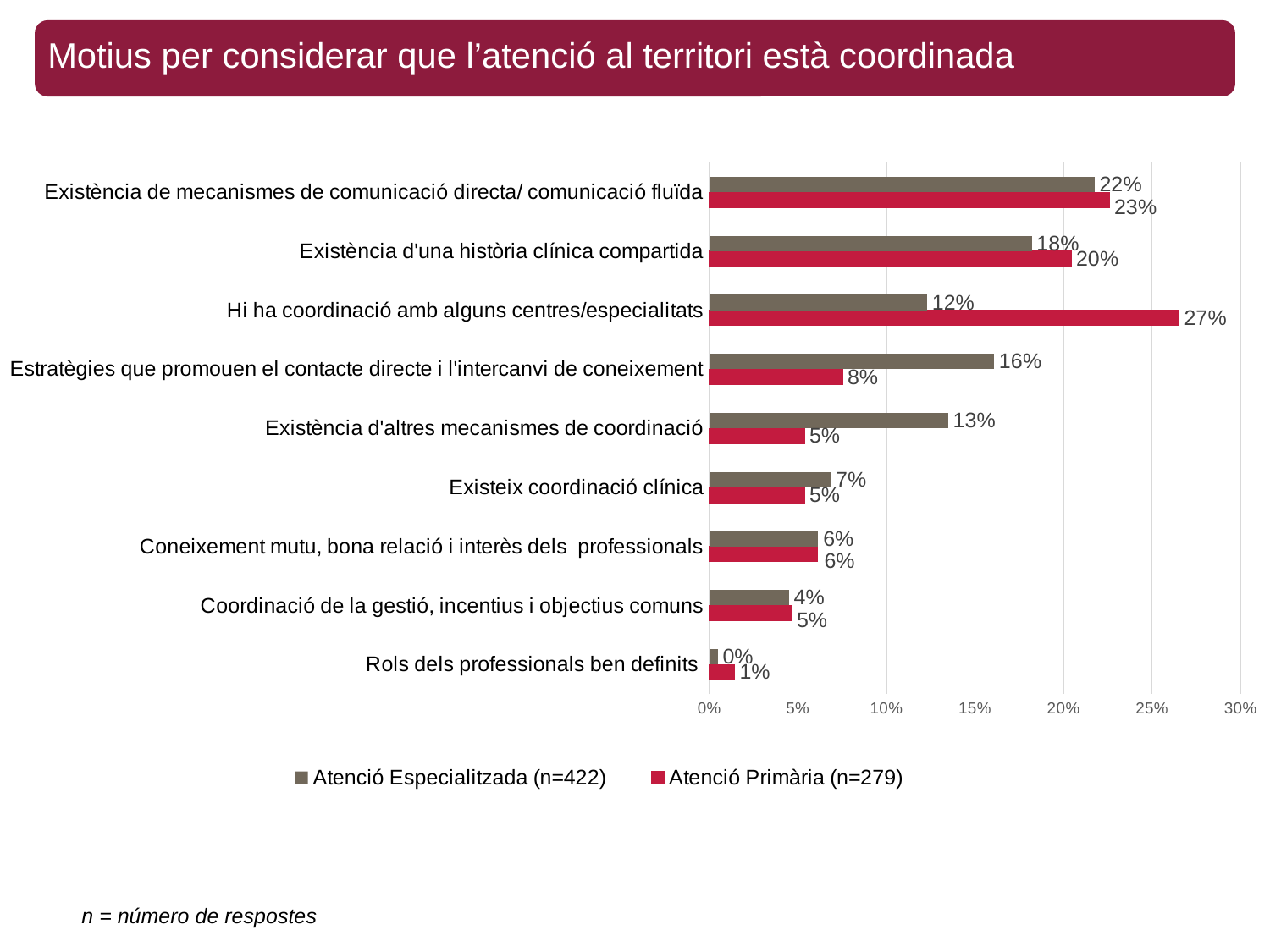
What is the value for Atenció Especialitzada for 'Existència d'una història clínica compartida'? 18% Which category has the lowest value for Atenció Especialitzada? Rols dels professionals ben definits What is the title of the chart? Motius per considerar que l'atenció al territori està coordinada For 'Existència d'altres mecanismes de coordinació', which series has the larger value, Atenció Especialitzada or Atenció Primària? Atenció Especialitzada What is the difference between the Atenció Primària and Atenció Especialitzada values for 'Hi ha coordinació amb alguns centres/especialitats'? 15% What is the sample size (n) for the Atenció Primària series according to the legend? 279 What kind of chart is shown on the slide? Bar chart What is the value for Atenció Primària for 'Hi ha coordinació amb alguns centres/especialitats'? 27% Which category has the highest value for Atenció Primària? Hi ha coordinació amb alguns centres/especialitats How many series does the legend list? 2 How many categories are shown in the chart? 9 What is the value for Atenció Especialitzada for 'Estratègies que promouen el contacte directe i l'intercanvi de coneixement'? 16%